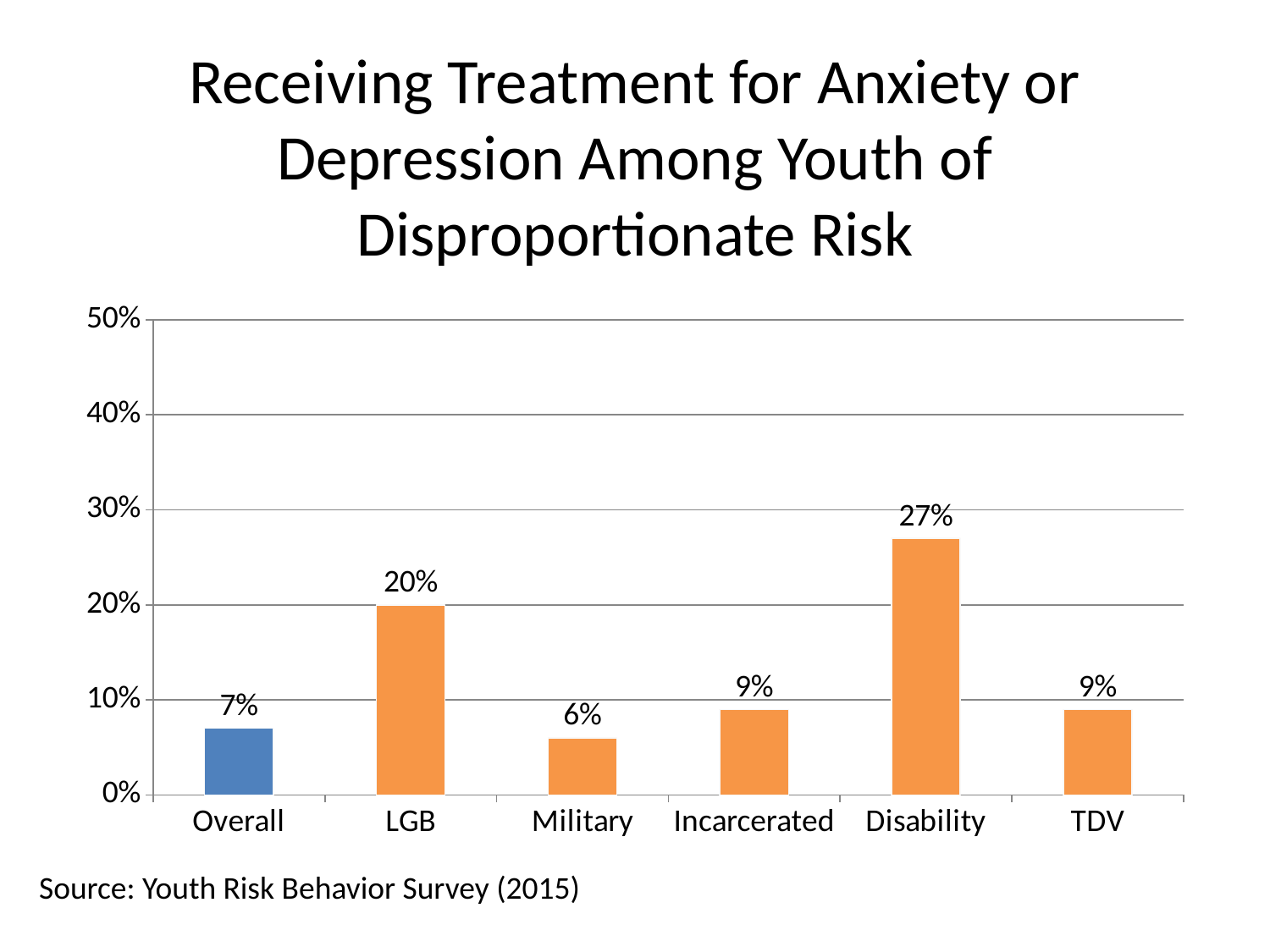
Which category has the highest value? Disability Is the value for Disability greater or less than 30%? less What is the difference between the values for Disability and LGB? 7% What is the value for Disability? 27% What is the value for Overall? 7% What is the value for Military? 6% Which is larger, the value for LGB or the value for TDV? LGB Which category has the lowest value? Military What is the difference between the values for Incarcerated and Overall? 2% How many categories are shown on the x axis? 6 What kind of chart is shown on the slide? Bar chart What is the value for LGB? 20%